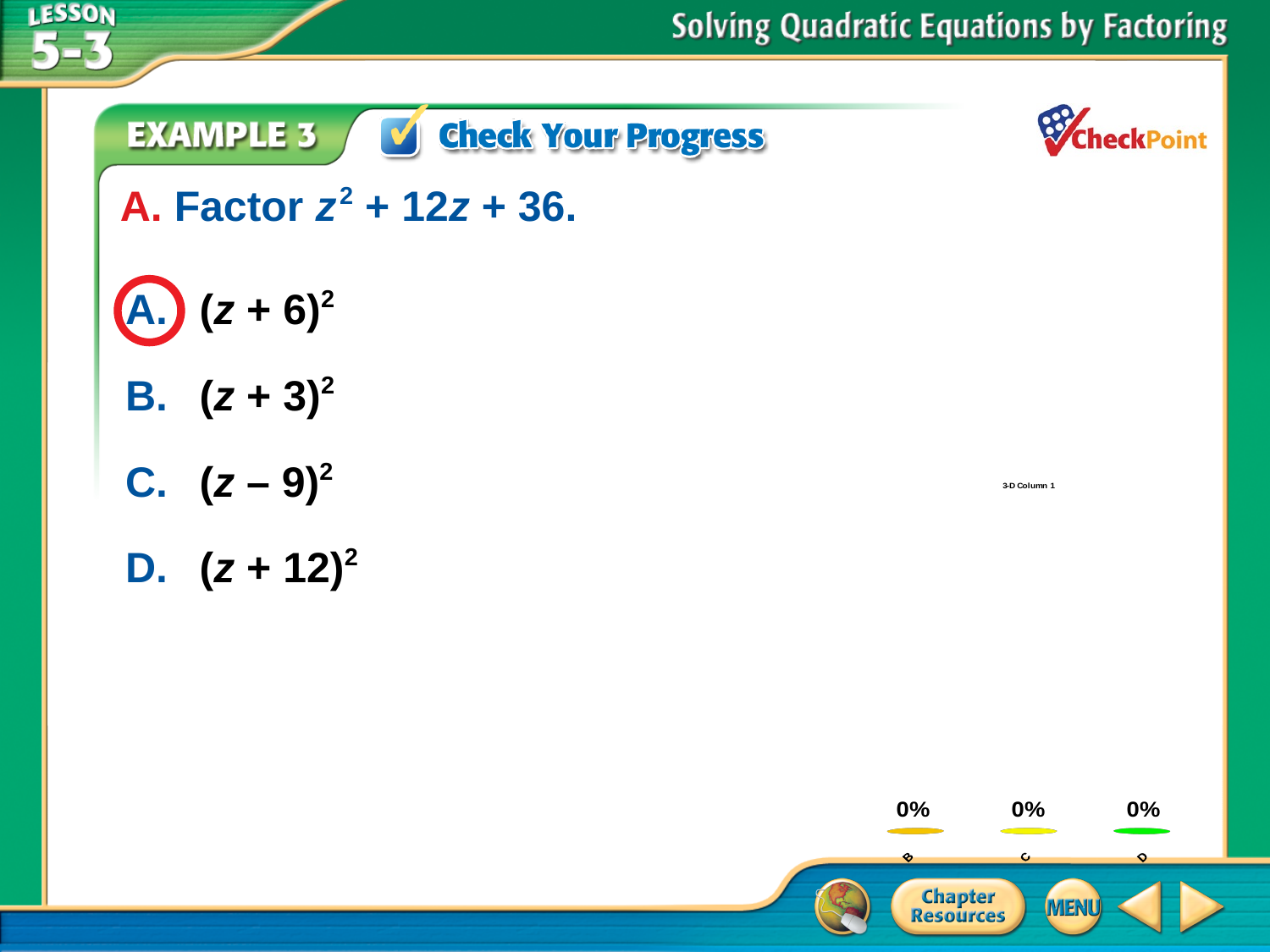
What colour is the bar for category D in the chart at the bottom right of the slide? green What is the value shown for category B in the chart at the bottom right of the slide? 0% What kind of chart is shown at the bottom right of the slide? bar chart What is the title of the chart at the bottom right of the slide? 3-D Column 1 What is the value shown for category C in the chart at the bottom right of the slide? 0% What is the difference between the values for B and D in the chart at the bottom right of the slide? 0% Do the values for B, C and D in the chart at the bottom right of the slide differ from one another? No, all are 0% What is the value shown for category D in the chart at the bottom right of the slide? 0%